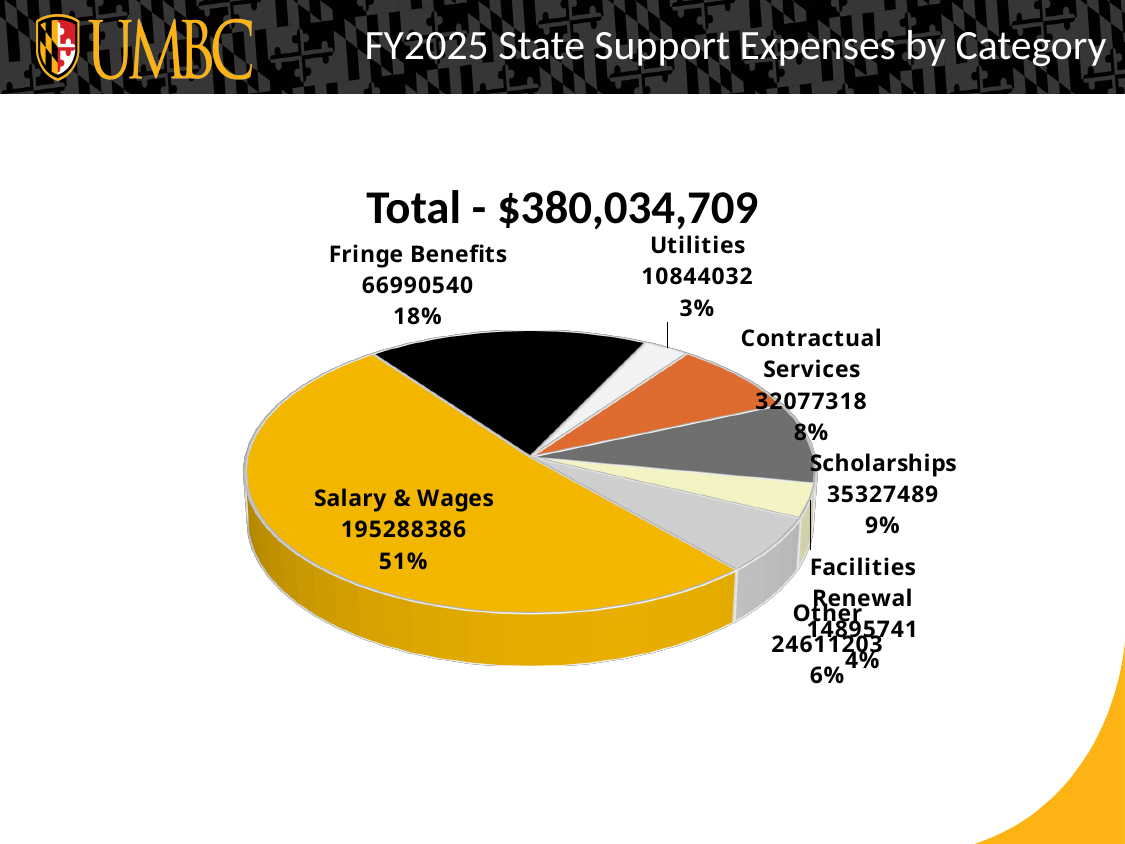
What is the value for Salary & Wages? 195288386 What is the value for Utilities? 10844032 What share of the pie does Facilities Renewal represent? 4% What total is stated in the chart title? $380,034,709 Which is larger, the value for Scholarships or the value for Other? Scholarships What is the value for Fringe Benefits? 66990540 What share of the pie does Contractual Services represent? 8% What is the value for Scholarships? 35327489 Which category has the smallest slice of the pie? Utilities How many categories are shown in the pie chart? 7 Which category has the largest slice of the pie? Salary & Wages What kind of chart is shown on the slide? Pie chart